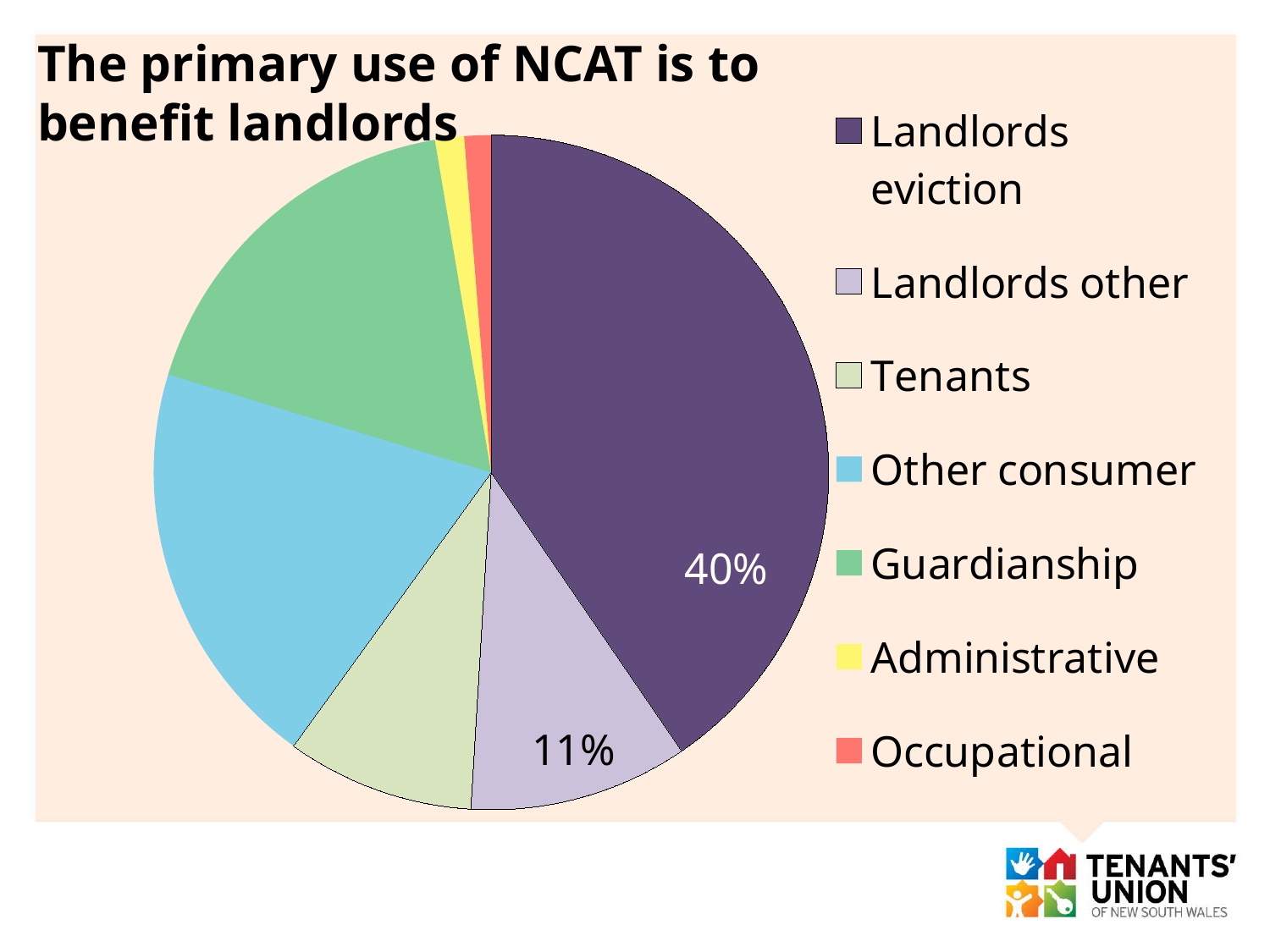
By how many percentage points is the Landlords eviction slice larger than the Landlords other slice? 29 percentage points Which slice is larger, Other consumer or Administrative? Other consumer Which slice is larger, Landlords eviction or Other consumer? Landlords eviction What colour is the Landlords eviction slice? Dark purple What percentage of the pie is the Landlords other slice? 11% What is the title of the slide? The primary use of NCAT is to benefit landlords Which category has the largest slice of the pie? Landlords eviction What percentage of the pie is the Landlords eviction slice? 40% What kind of chart is shown on the slide? Pie chart Which slice is larger, Guardianship or Tenants? Guardianship How many categories does the pie chart show? 7